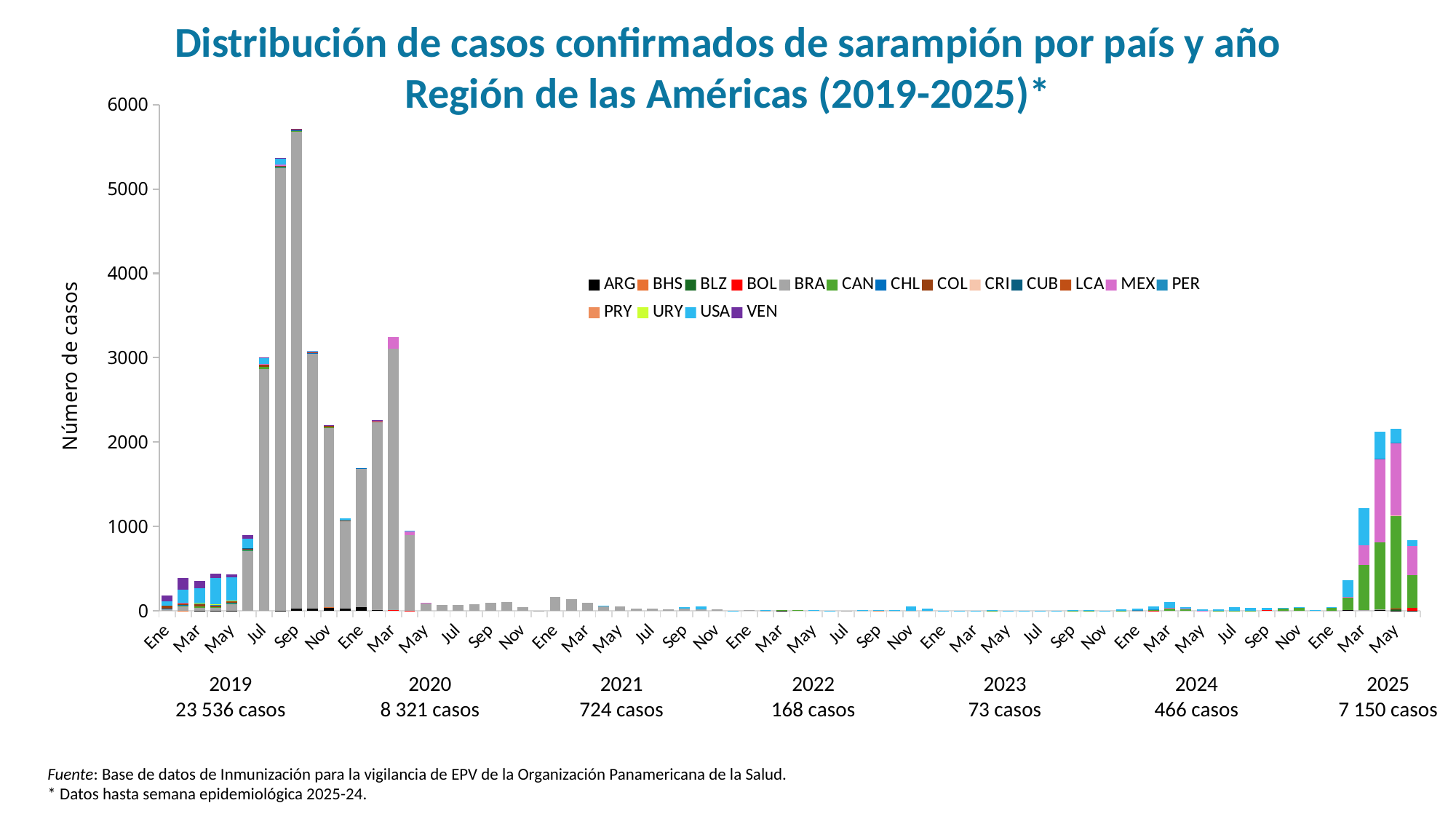
What is the difference between the annual totals for 2019 and 2020? 15 215 casos Which year has the highest annual total of cases? 2019 How many confirmed cases are reported for 2025? 7 150 casos What is the label on the y axis? Número de casos Which year has more cases, 2020 or 2025? 2020 Which year has the lowest annual total of cases? 2023 How many countries (series) does the legend list? 17 Is the value for Sep 2019 greater or less than 5000? greater Do the annual totals rise or fall from 2021 to 2023? fall How many confirmed cases are reported for 2019? 23 536 casos What kind of chart is shown on the slide? bar chart How many confirmed cases are reported for 2022? 168 casos